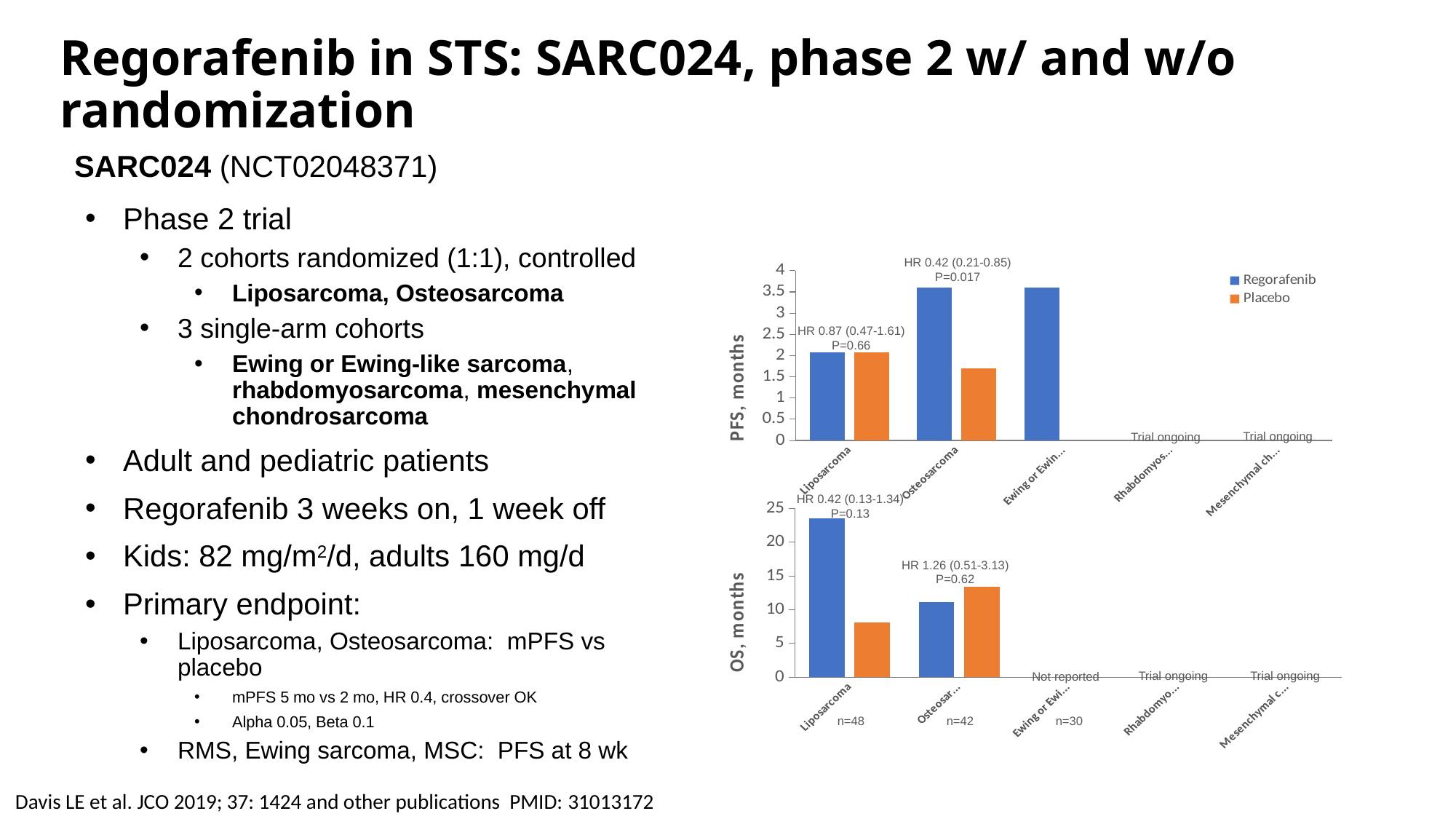
How many series does the legend of the top chart (PFS, months) list? 2 In the bottom chart (OS, months), is the Placebo value for Liposarcoma greater or less than 10? less In the top chart (PFS, months), is the Placebo value for Osteosarcoma greater or less than 2? less In the bottom chart (OS, months), what text is shown in place of bars for the Ewing or Ewing-like sarcoma category? Not reported In the top chart (PFS, months), what hazard ratio is printed above the Osteosarcoma bars? HR 0.42 (0.21-0.85) What kind of chart is the top chart (PFS, months)? bar chart In the bottom chart (OS, months), is the Regorafenib value for Liposarcoma greater or less than 20? greater In the top chart (PFS, months), which is larger for Osteosarcoma, Regorafenib or Placebo? Regorafenib How many categories are shown on the x axis of the top chart (PFS, months)? 5 In the bottom chart (OS, months), which is larger for Osteosarcoma, Regorafenib or Placebo? Placebo In the bottom chart (OS, months), which category has the highest Regorafenib value? Liposarcoma